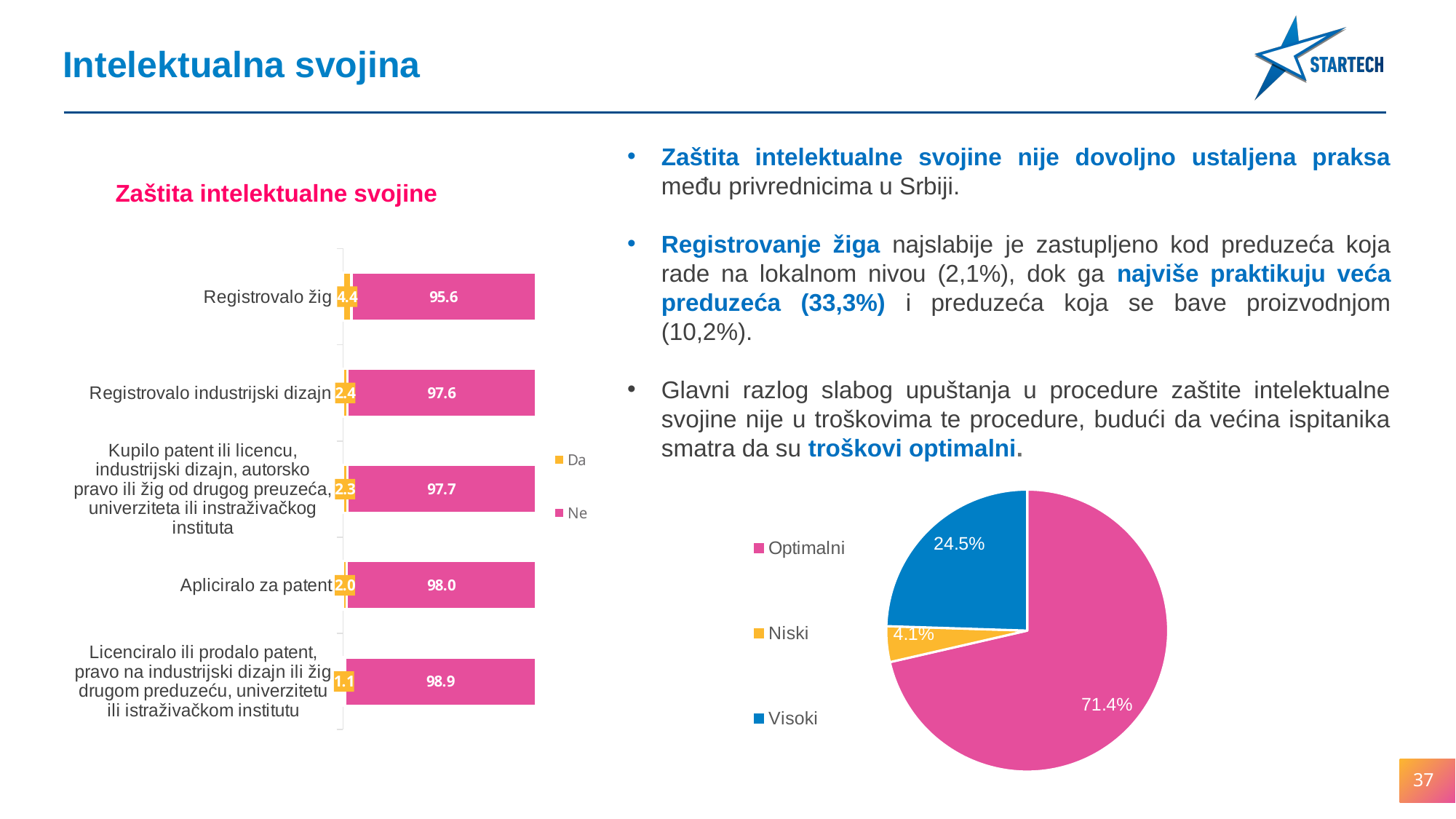
In the chart titled 'Zaštita intelektualne svojine', what is the 'Da' value for 'Registrovalo industrijski dizajn'? 2.4 In the chart titled 'Zaštita intelektualne svojine', what is the 'Da' value for 'Apliciralo za patent'? 2.0 In the chart titled 'Zaštita intelektualne svojine', what is the 'Ne' value for 'Registrovalo žig'? 95.6 In the chart titled 'Zaštita intelektualne svojine', which category has the lowest 'Da' value? Licenciralo ili prodalo patent, pravo na industrijski dizajn ili žig drugom preduzeću, univerzitetu ili istraživačkom institutu In the pie chart on the right of the slide, which slice is the smallest? Niski What kind of chart is the chart titled 'Zaštita intelektualne svojine'? Stacked bar chart In the chart titled 'Zaštita intelektualne svojine', how many categories are shown? 5 In the chart titled 'Zaštita intelektualne svojine', what is the difference between the 'Ne' values for 'Registrovalo žig' and 'Apliciralo za patent'? 2.4 In the chart titled 'Zaštita intelektualne svojine', how many series does the legend list? 2 In the pie chart on the right of the slide, what share does 'Optimalni' have? 71.4% In the pie chart on the right of the slide, which is larger: 'Visoki' or 'Niski'? Visoki In the chart titled 'Zaštita intelektualne svojine', which category has the highest 'Da' value? Registrovalo žig